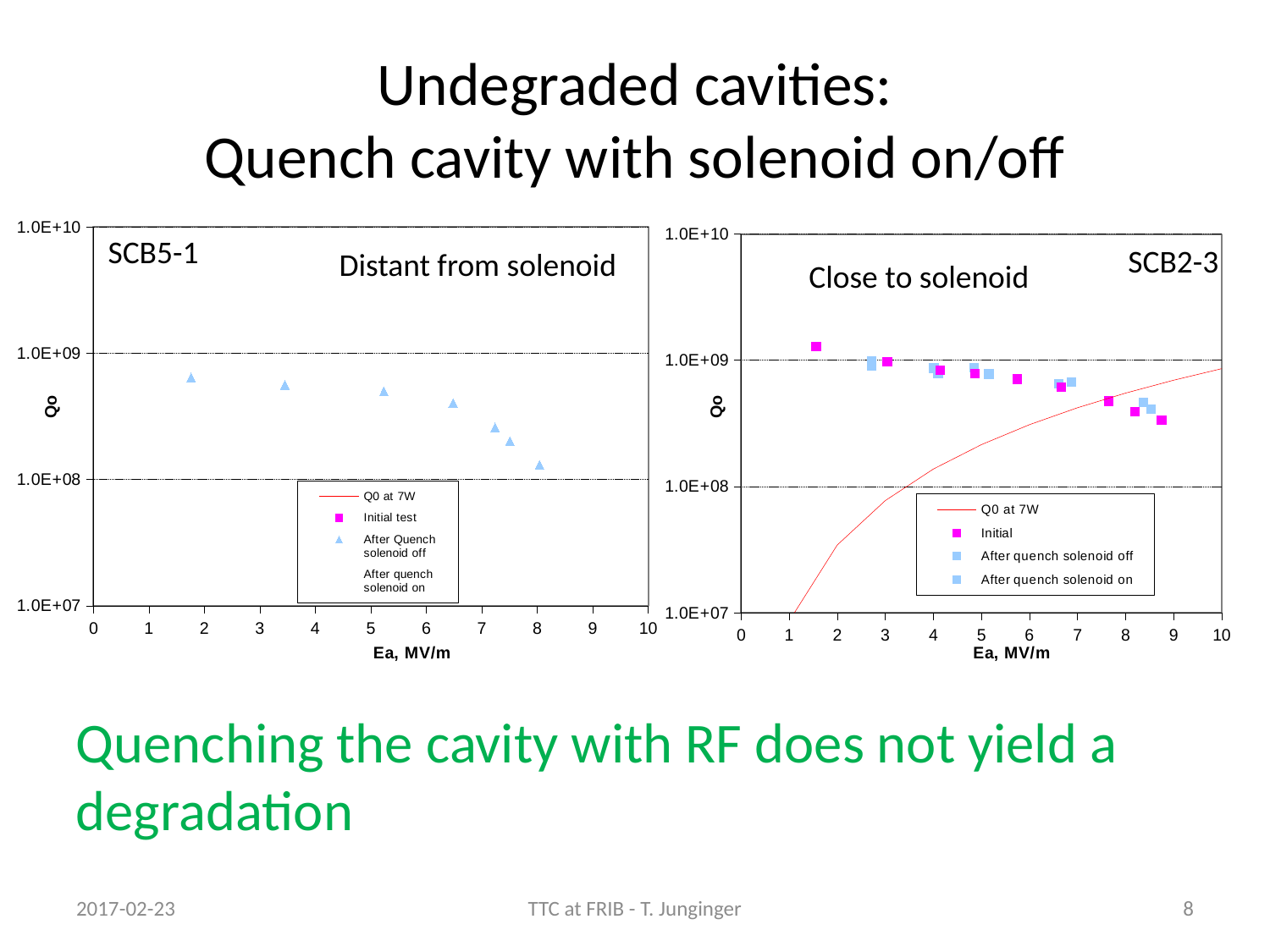
In the right chart (SCB2-3), do the measured Q0 values rise or fall as Ea increases? fall How many series does the legend of the right chart (SCB2-3) list? 4 In the left chart (SCB5-1), how many 'After Quench solenoid off' data points are plotted? 7 Which chart is labeled 'Close to solenoid'? SCB2-3 In the left chart (SCB5-1), do the Q0 values rise or fall as Ea increases? fall How many series does the legend of the left chart (SCB5-1) list? 4 What is the x-axis label of the right chart (SCB2-3)? Ea, MV/m In the right chart (SCB2-3), is the Q0 value of the 'Initial' point near 1.5 MV/m greater or less than 1.0E+09? greater In the left chart (SCB5-1), is the Q0 value of the first data point (near 2 MV/m) greater or less than 1.0E+09? less In the left chart (SCB5-1), is the Q0 value of the data point at about 8 MV/m greater or less than 1.0E+08? greater What kind of chart is the left chart (SCB5-1)? scatter chart